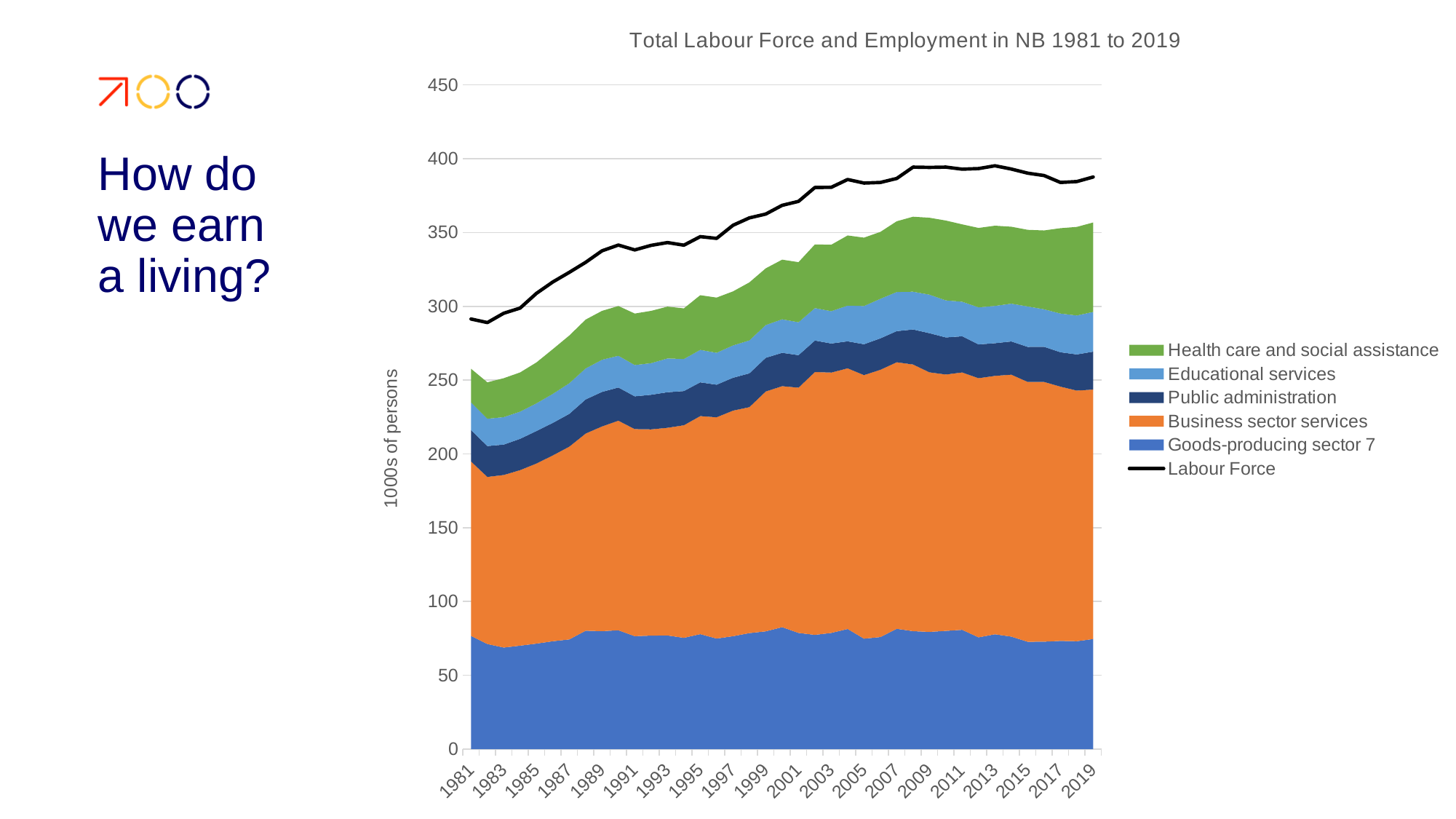
What is the label on the vertical axis? 1000s of persons Which is larger, the Labour Force in 1981 or the Labour Force in 2019? 2019 Is the total of the stacked areas in 2019 greater or less than 400? less How many series does the legend list? 6 What is the title of the chart? Total Labour Force and Employment in NB 1981 to 2019 Is the Labour Force value in 2009 greater or less than 350? greater Is the Labour Force value in 2019 greater or less than 350? greater Which series occupies the largest area in the stacked chart, Business sector services or Public administration? Business sector services Does the Labour Force line generally rise or fall from 1981 to 2019? rise What kind of chart is shown on the slide? Stacked area chart with a line